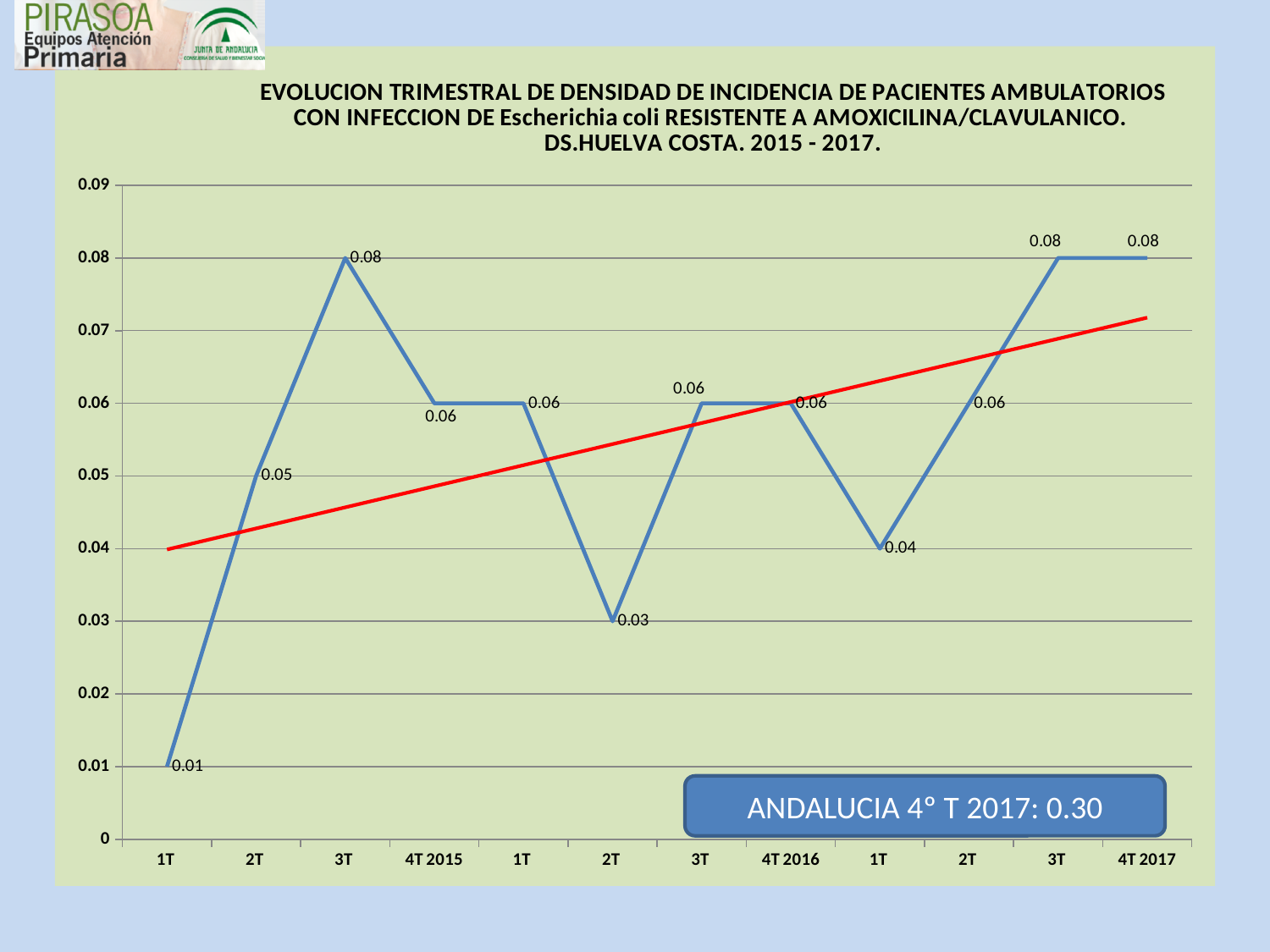
What is the value for 4T 2017? 0.08 Which is larger, the value for 2T 2015 or the value for 1T 2017? 2T 2015 What is the value for 1T 2015? 0.01 What value is given for Andalucia in the box on the chart for 4° T 2017? 0.30 What is the value for 1T 2017? 0.04 What is the difference between the values for 3T 2015 and 2T 2016? 0.05 What kind of chart is shown on the slide? Line chart What is the value for 2T 2016? 0.03 How many quarters are plotted on the x axis? 12 Which quarter has the lowest value? 1T 2015 What is the difference between the values for 4T 2017 and 1T 2017? 0.04 Does the red trend line rise or fall from left to right? Rises